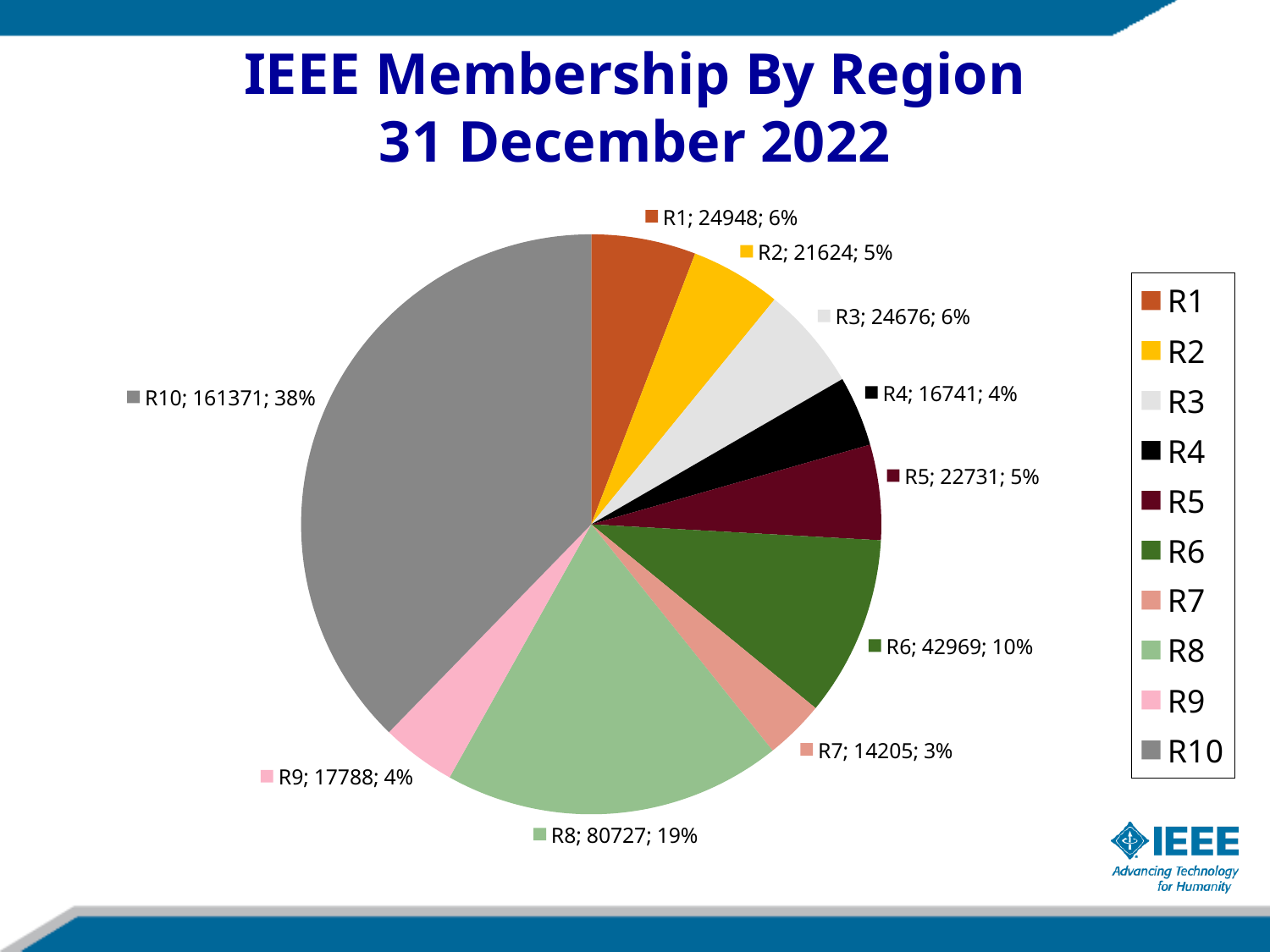
What type of chart is shown on the slide? pie chart Which has more members, R1 or R2? R1 What is the difference in membership between R8 and R6? 37758 What is the membership value for R4? 16741 What percentage share of membership does R10 have? 38% Which region has the largest share of membership? R10 What is the title of the chart? IEEE Membership By Region 31 December 2022 What is the membership value for R10? 161371 What percentage share of membership does R6 have? 10% What is the membership value for R8? 80727 Which region has the smallest share of membership? R7 How many regions are shown in the pie chart? 10